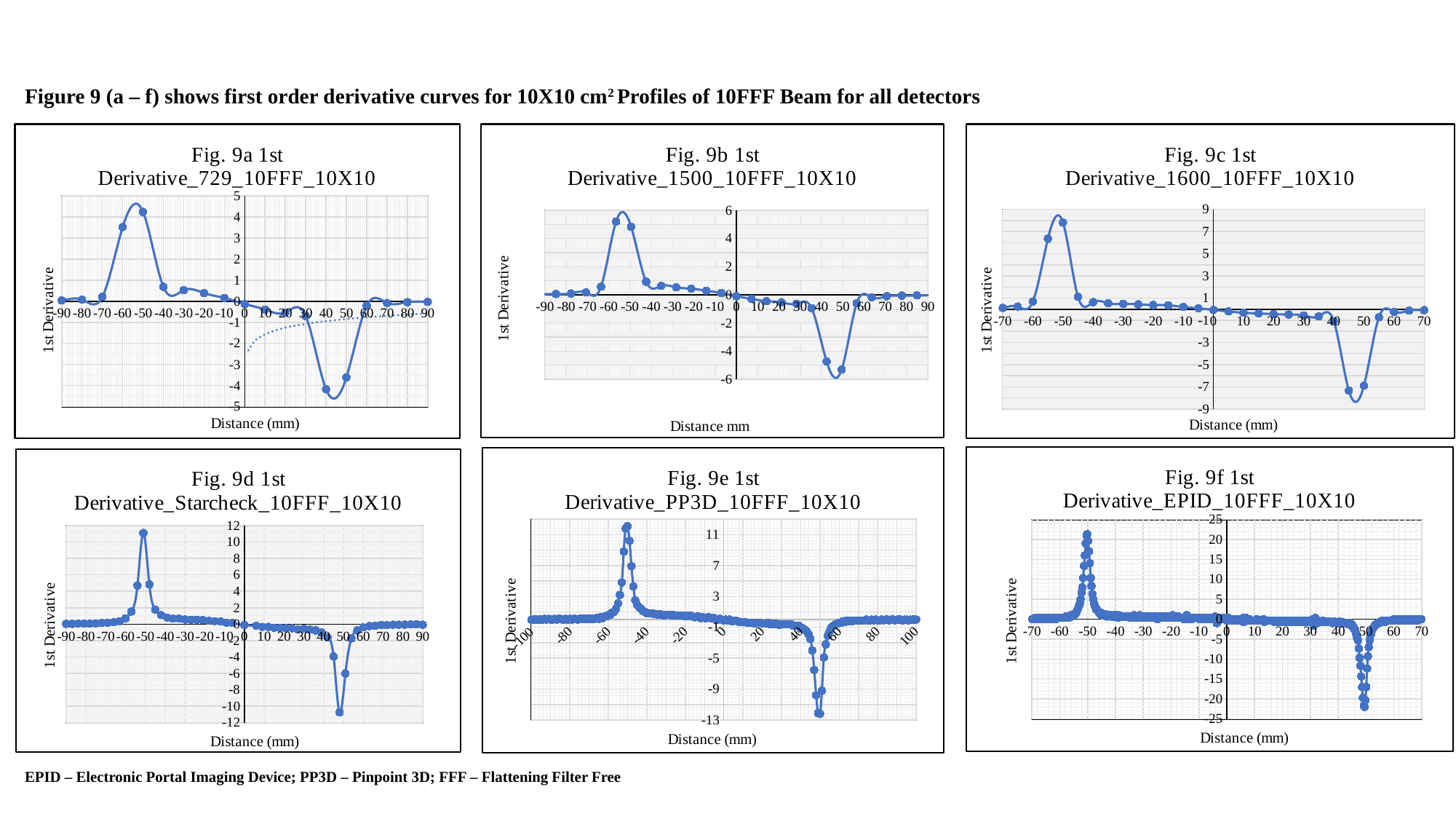
What is the x-axis title of Fig. 9d 1st Derivative_Starcheck_10FFF_10X10? Distance (mm) What kind of chart is Fig. 9a 1st Derivative_729_10FFF_10X10? line chart In Fig. 9c 1st Derivative_1600_10FFF_10X10, is the peak value near -50 mm greater or less than 7? greater What is the maximum value shown on the y-axis of Fig. 9f 1st Derivative_EPID_10FFF_10X10? 25 In Fig. 9c 1st Derivative_1600_10FFF_10X10, does the curve rise or fall between -60 mm and -50 mm? rise In Fig. 9a 1st Derivative_729_10FFF_10X10, is the peak value near -50 mm greater or less than 4? greater Which chart has the higher positive peak: Fig. 9d 1st Derivative_Starcheck_10FFF_10X10 or Fig. 9a 1st Derivative_729_10FFF_10X10? Fig. 9d 1st Derivative_Starcheck_10FFF_10X10 In Fig. 9f 1st Derivative_EPID_10FFF_10X10, is the lowest value near 50 mm greater or less than -20? less How many charts are shown on the slide? 6